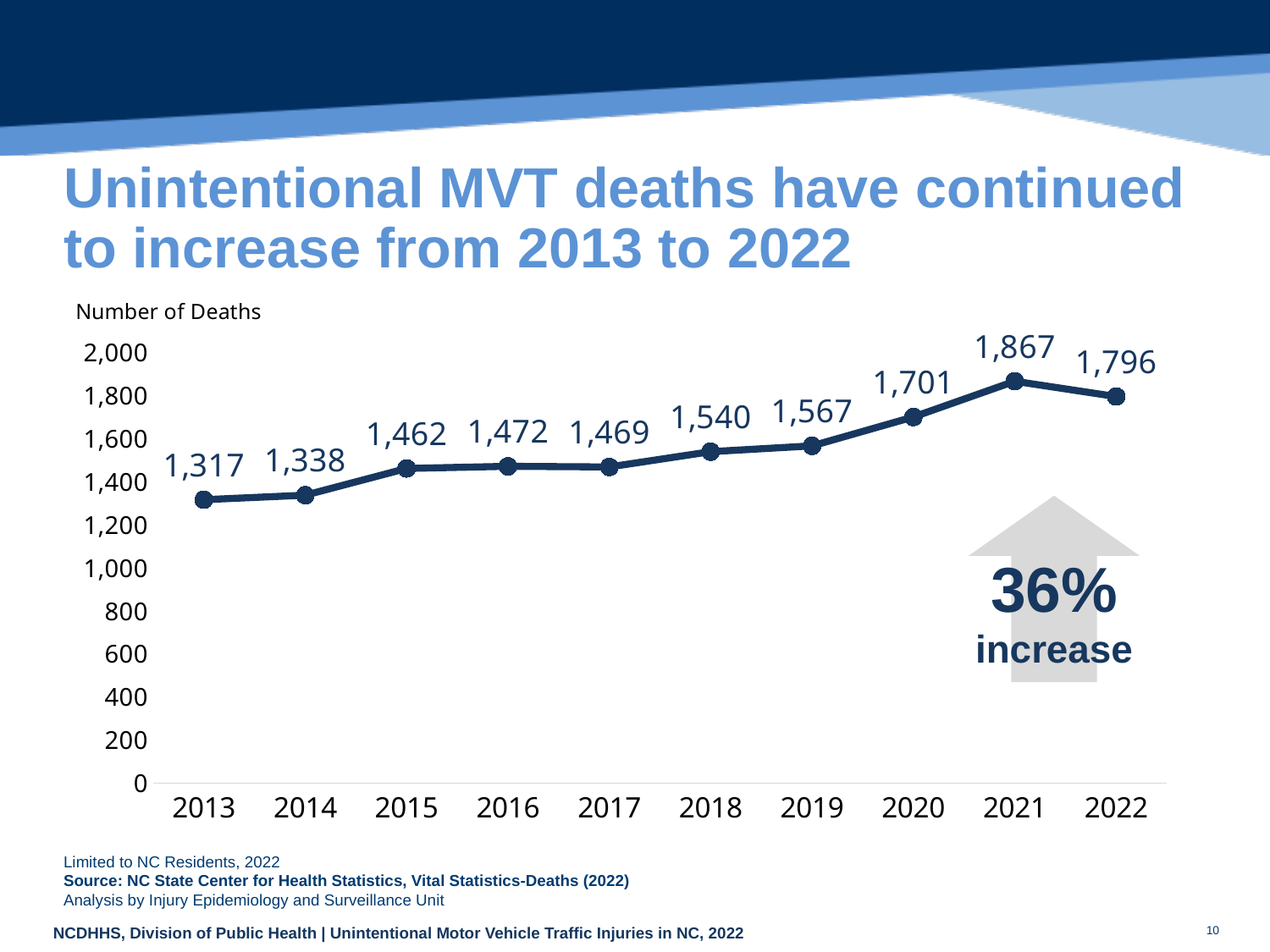
How many years are plotted on the chart? 10 What kind of chart is shown on the slide? Line chart What percentage increase is called out in the arrow on the chart? 36% What is the difference in the number of deaths between 2021 and 2020? 166 What is the number of deaths in 2013? 1,317 Which year has more deaths, 2019 or 2020? 2020 What is the number of deaths in 2021? 1,867 What is the number of deaths in 2018? 1,540 What is the difference in the number of deaths between 2022 and 2013? 479 Which year has the lowest number of deaths? 2013 What is the number of deaths in 2022? 1,796 Which year has the highest number of deaths? 2021